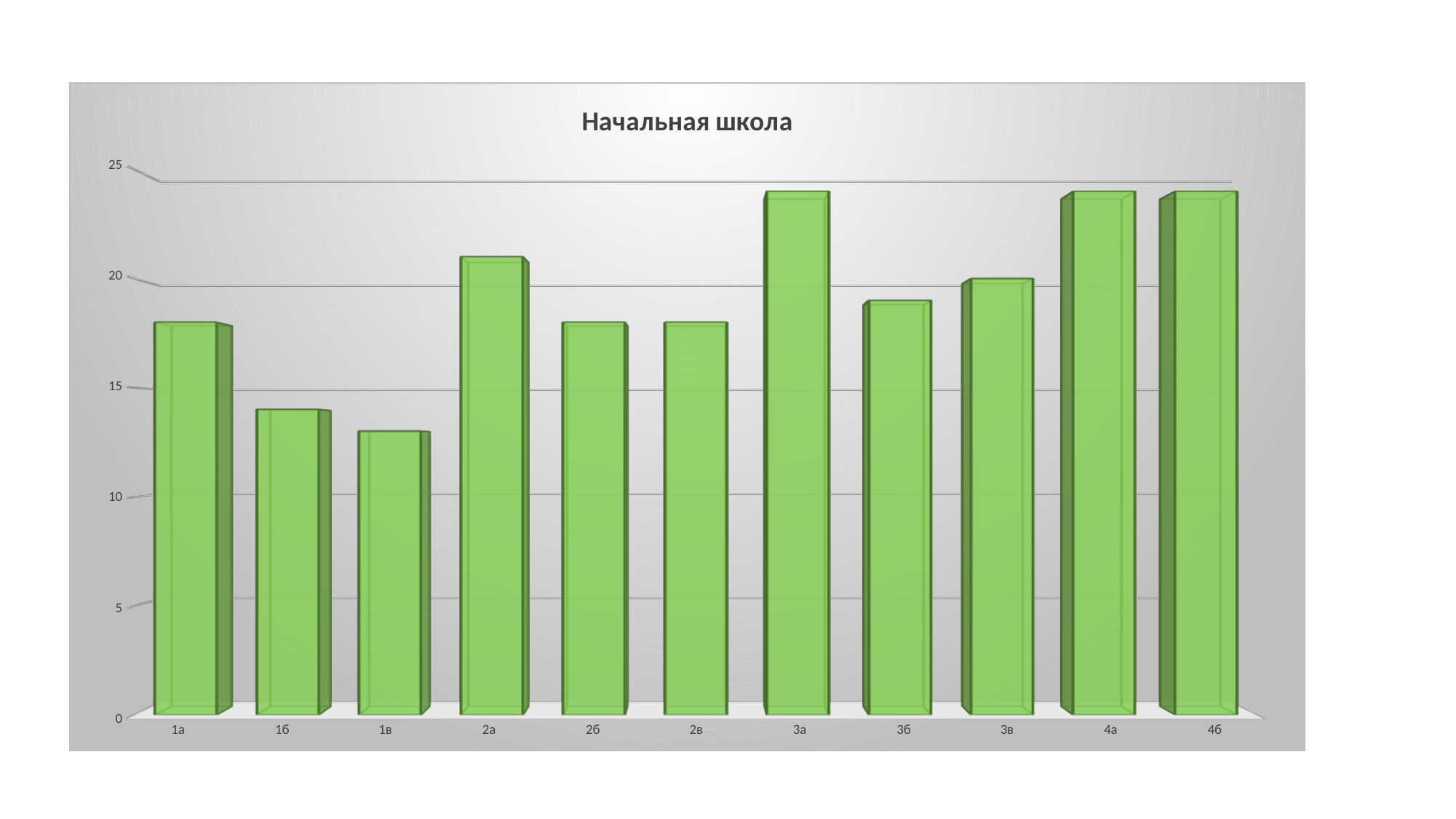
Which has the larger value, 3а or 3б? 3а What is the title of the chart? Начальная школа How many categories are shown on the x axis of the chart? 11 Which has the larger value, 2а or 2б? 2а What kind of chart is shown on the slide? bar chart Which category has the lowest value in the chart? 1в Is the value for 3б greater or less than 20? less Which has the larger value, 1а or 1б? 1а Is the value for 1в greater or less than 15? less Is the value for 3а greater or less than 20? greater